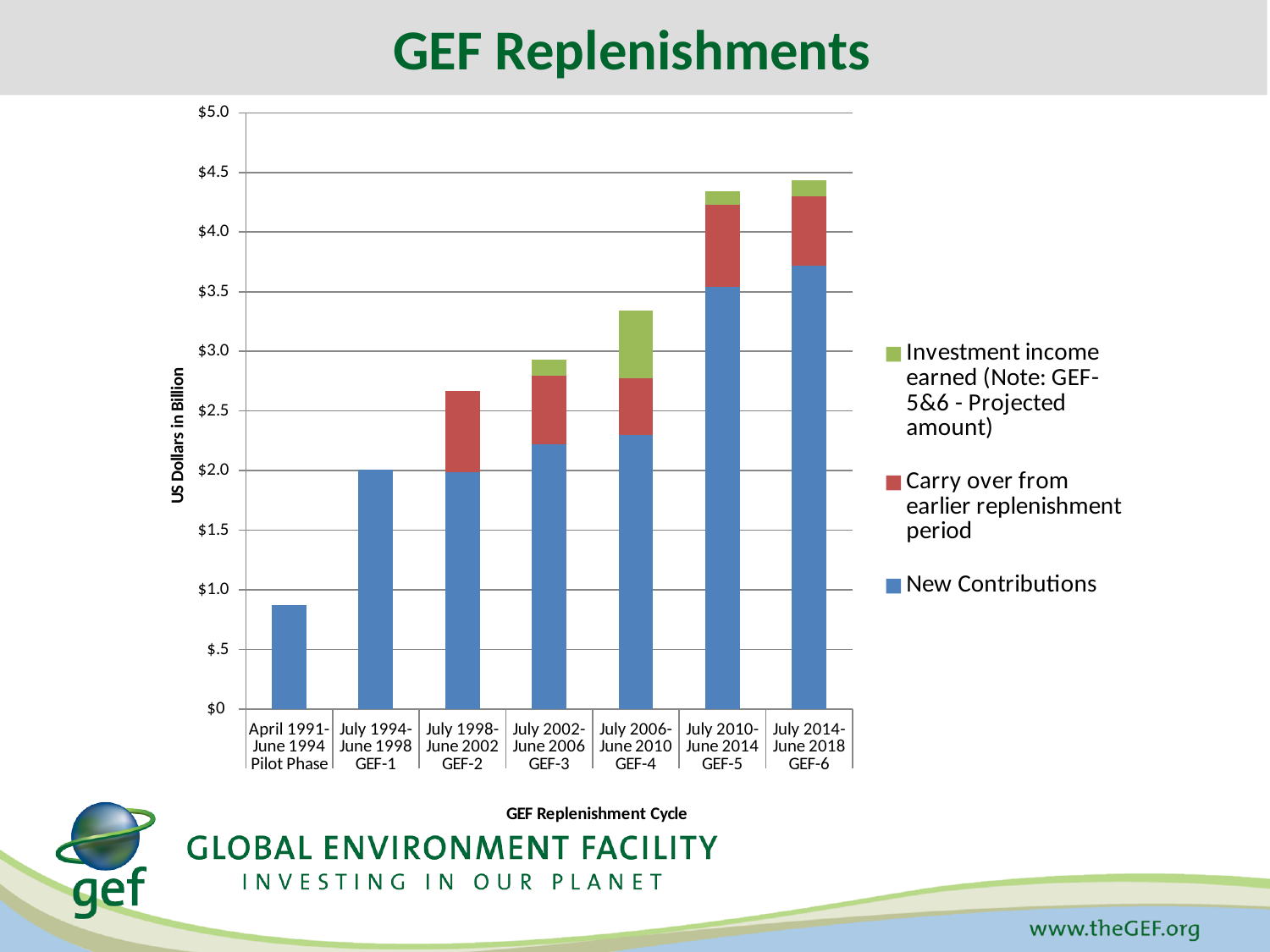
What is the label of the y axis? US Dollars in Billion How many replenishment cycles are shown on the x axis? 7 Which replenishment cycle has the lowest total bar? April 1991-June 1994 Pilot Phase Is the New Contributions value for GEF-5 greater or less than $3.0 billion? greater Which cycle has the larger Investment income earned segment, GEF-3 or GEF-4? GEF-4 How many series does the legend list? 3 Is the total value for GEF-6 greater or less than $4.0 billion? greater What kind of chart is shown on the slide? Stacked bar chart Is the total value for the Pilot Phase greater or less than $1.0 billion? less Which series is shown in blue in the legend? New Contributions Do the total replenishment amounts generally rise or fall from the Pilot Phase to GEF-6? rise